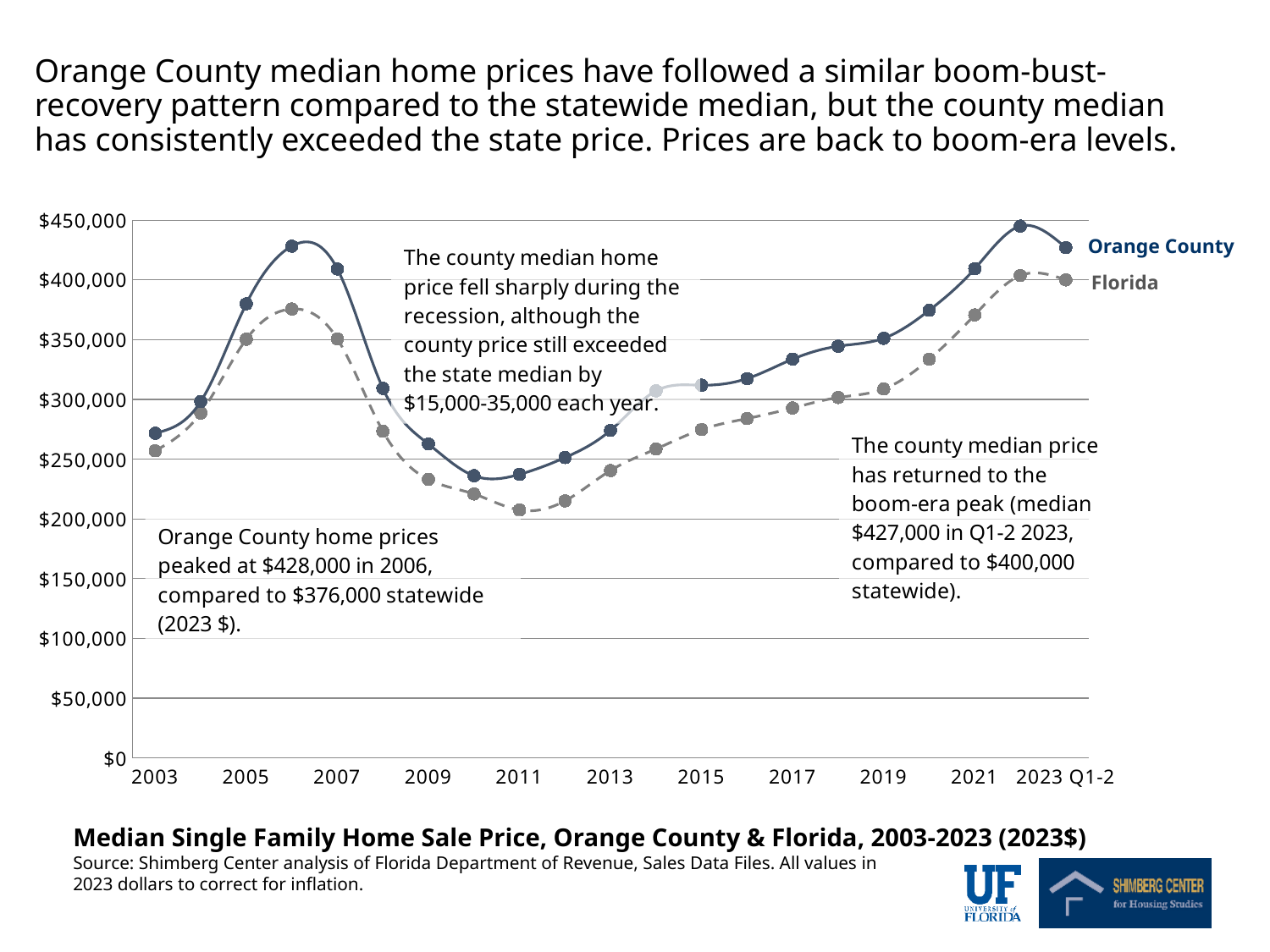
How many series does the chart show? 2 What is the difference between the Orange County median ($427,000) and the statewide median ($400,000) in Q1-2 2023? $27,000 According to the annotation, what was the Orange County median home price at its 2006 peak? $428,000 Is the Orange County value for 2011 greater or less than $250,000? less Do the Orange County values rise or fall between 2006 and 2011? fall According to the annotation, what was the statewide median home price in 2006? $376,000 In which year does the Orange County line reach its highest value? 2022 What kind of chart is shown on the slide? line chart Is the Florida value for 2003 greater or less than $300,000? less Which two series are labelled on the chart? Orange County and Florida What is the difference between the Orange County median ($428,000) and the statewide median ($376,000) in 2006? $52,000 According to the annotation, what was the Orange County median price in Q1-2 2023? $427,000